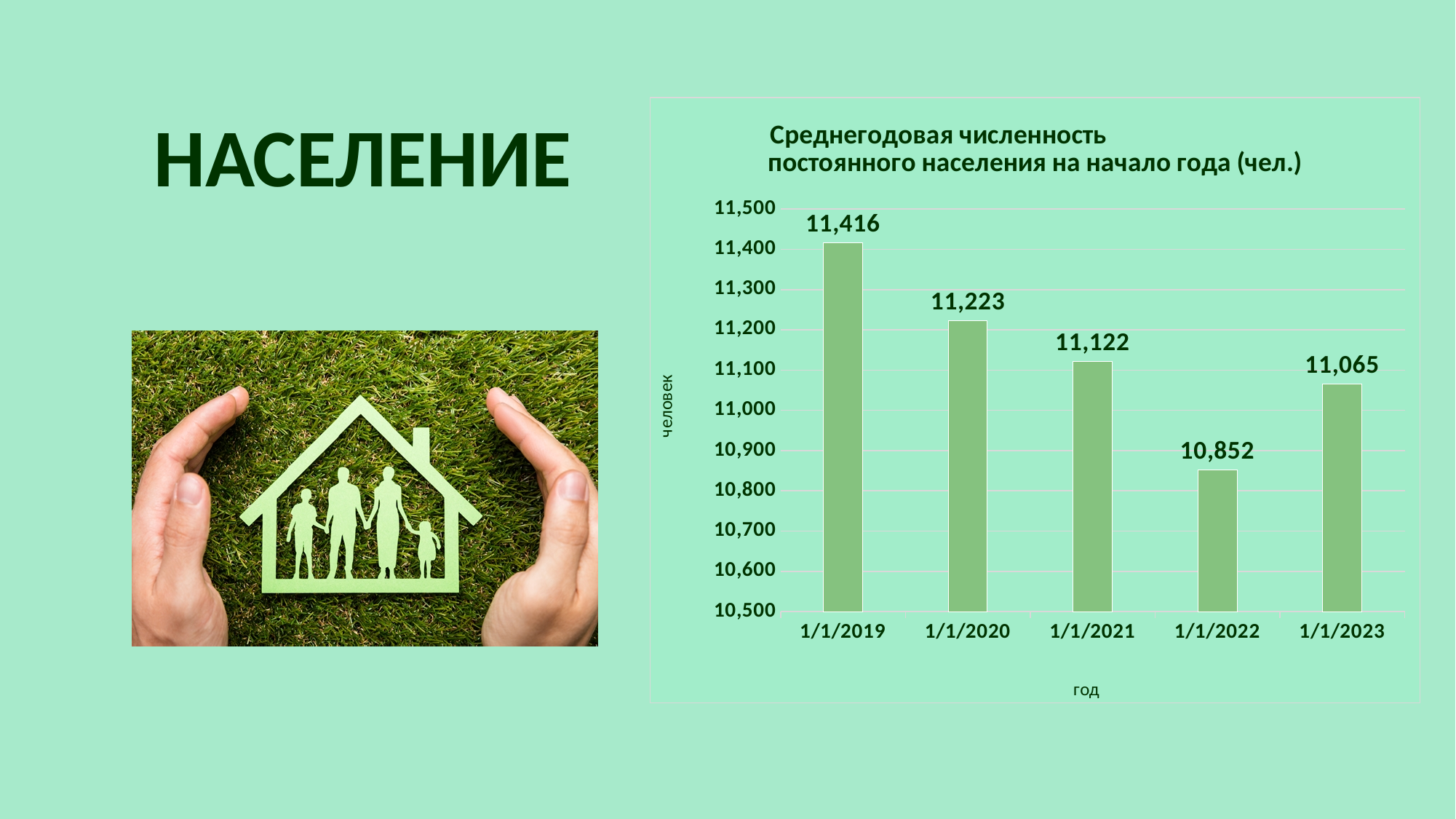
Which year has the lowest value? 1/1/2022 What is the value for 1/1/2022? 10,852 Is the value for 1/1/2022 greater or less than 10,900? less Do the values rise or fall from 1/1/2019 to 1/1/2022? fall How many years are shown on the x axis? 5 Which year has the highest value? 1/1/2019 What is the value for 1/1/2019? 11,416 What is the difference between the values for 1/1/2023 and 1/1/2022? 213 What kind of chart is shown? bar chart What is the difference between the values for 1/1/2019 and 1/1/2020? 193 What is the value for 1/1/2023? 11,065 Which is larger, the value for 1/1/2021 or the value for 1/1/2023? 1/1/2021